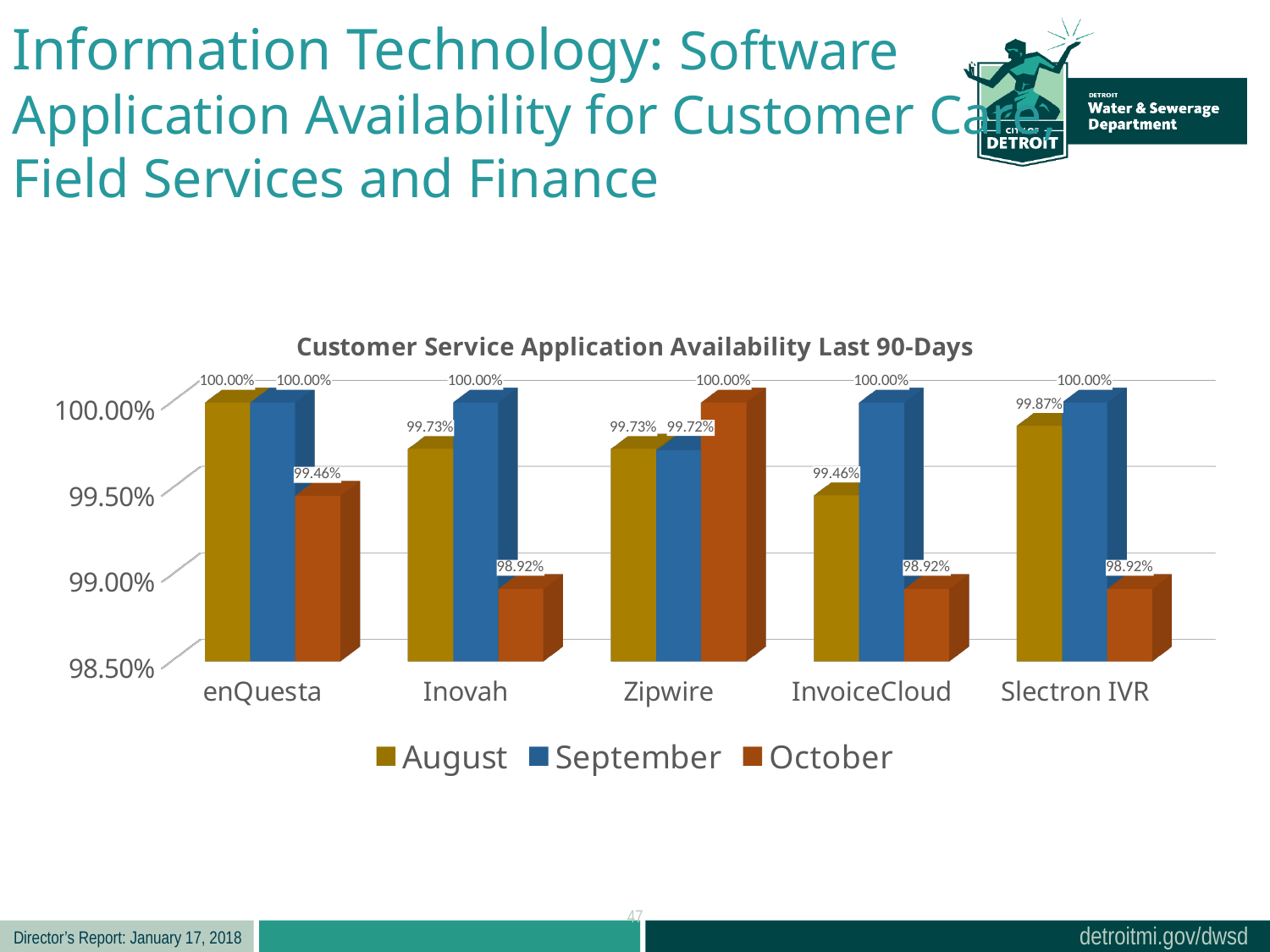
What is the difference between the August and October availability for Inovah? 0.81% Which application has the highest October availability? Zipwire How many series does the legend list? 3 What is the August availability for Inovah? 99.73% What is the September availability for Zipwire? 99.72% Which is larger, the October availability for enQuesta or the October availability for Slectron IVR? enQuesta How many applications are shown on the x axis? 5 What is the October availability for InvoiceCloud? 98.92% What is the October availability for enQuesta? 99.46% What is the August availability for Slectron IVR? 99.87% Which application has the lowest August availability? InvoiceCloud What kind of chart is shown on the slide? Bar chart